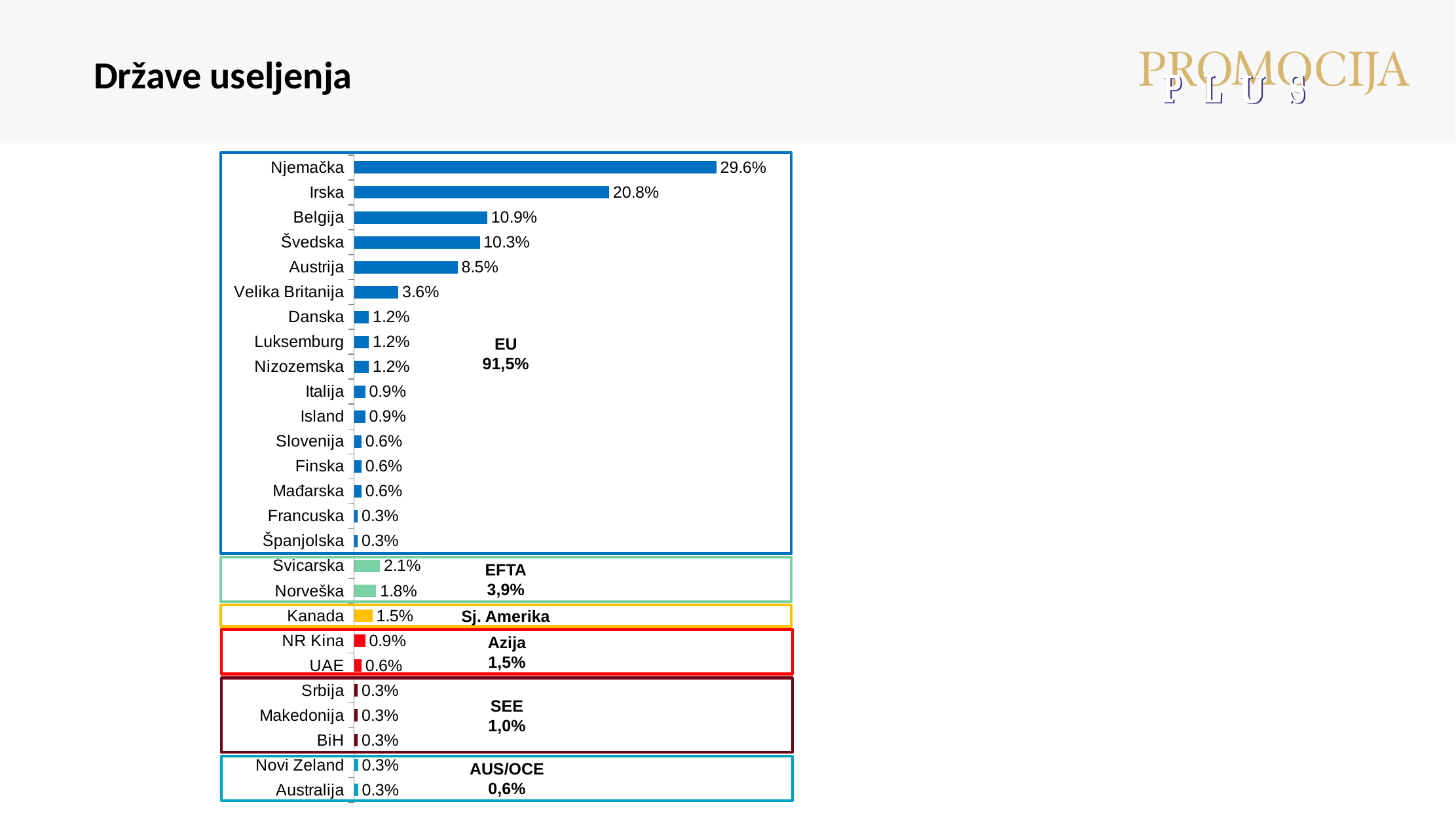
What kind of chart is shown on the slide? bar chart What is the value for Irska? 20.8% What is the value for Njemačka? 29.6% What is the value for Svicarska? 2.1% What total share is shown for the EU group? 91,5% What is the difference between the values for Njemačka and Irska? 8.8% Which country has the highest value? Njemačka What is the value for Kanada? 1.5% How many countries are plotted on the chart? 26 What total share is shown for the EFTA group? 3,9% What is the difference between the values for Belgija and Švedska? 0.6% Which is larger, the value for Austrija or the value for Velika Britanija? Austrija